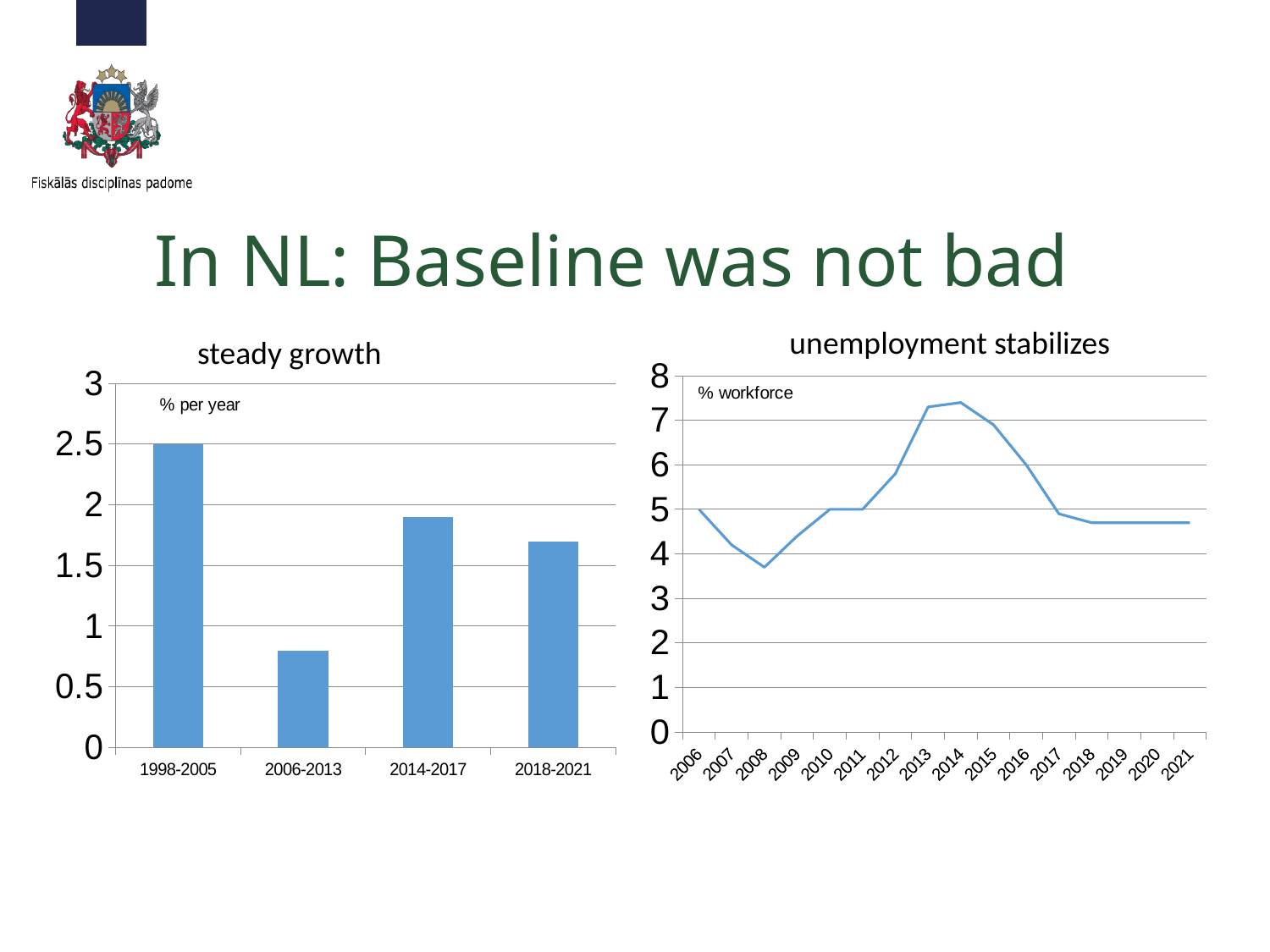
In the 'steady growth' chart, which period has the lowest growth? 2006-2013 What unit label is shown inside the 'unemployment stabilizes' chart? % workforce In the 'steady growth' chart, what is the value for 1998-2005? 2.5 What kind of chart is the 'steady growth' chart on the left? bar chart In the 'steady growth' chart, is the value for 2006-2013 greater or less than 1? less In the 'steady growth' chart, which is larger, the value for 2014-2017 or the value for 2018-2021? 2014-2017 In the 'unemployment stabilizes' chart, which year has the highest unemployment? 2014 In the 'unemployment stabilizes' chart, how many years are shown on the x axis? 16 In the 'steady growth' chart, which period has the highest growth? 1998-2005 In the 'steady growth' chart, how many periods are shown on the x axis? 4 In the 'unemployment stabilizes' chart, is the value for 2008 greater or less than 4? less What kind of chart is the 'unemployment stabilizes' chart on the right? line chart